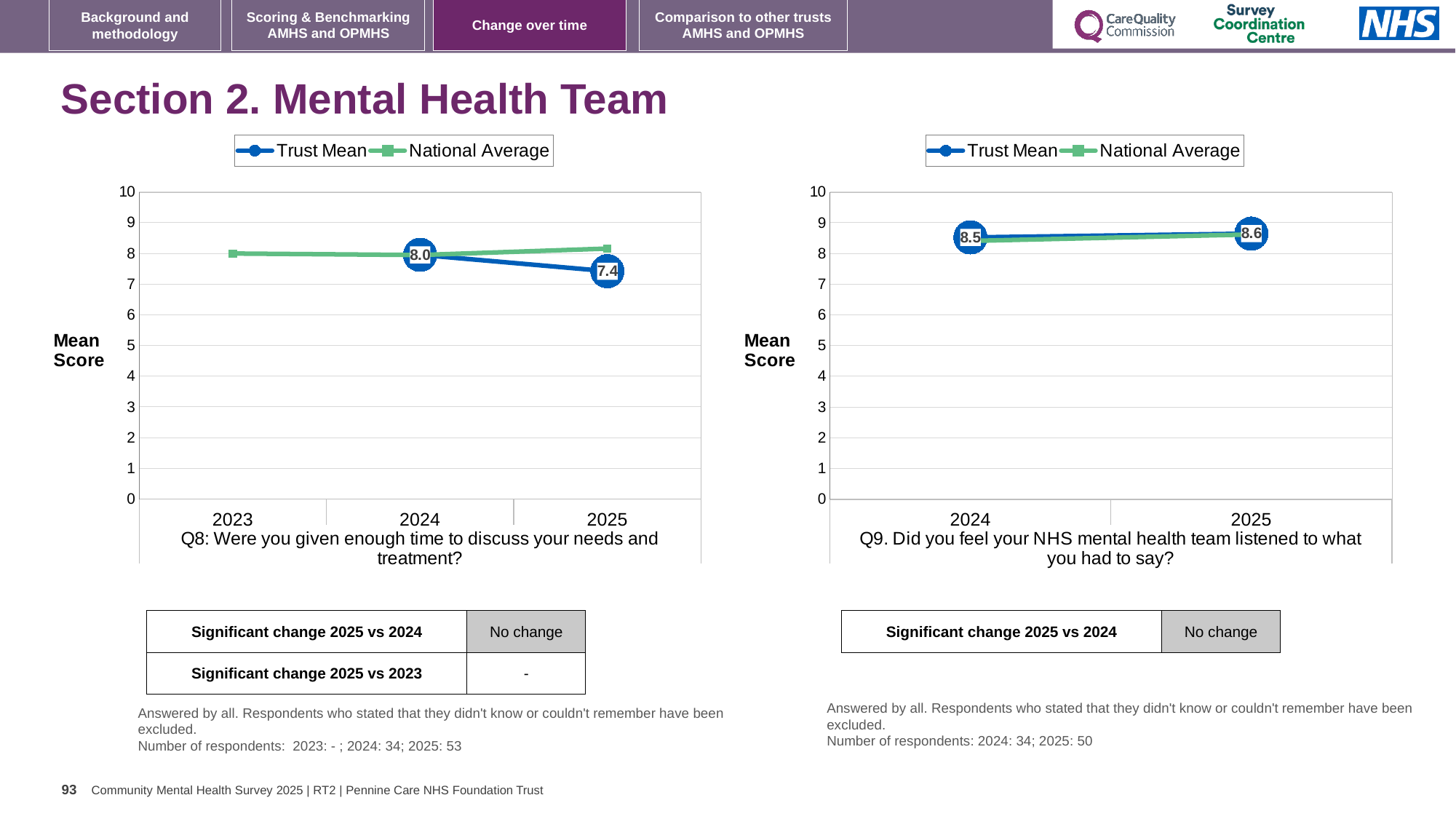
How many series does the legend of the Q8 chart on the left list? 2 In the Q8 chart on the left, what is the Trust Mean for 2024? 8.0 What kind of chart is the Q9 chart on the right? line chart In the Q8 chart on the left, which year has the lower Trust Mean, 2024 or 2025? 2025 In the Q8 chart on the left, does the Trust Mean rise or fall from 2024 to 2025? fall In the Q8 chart on the left, is the National Average for 2023 greater or less than 5? greater In the Q8 chart on the left, what is the Trust Mean for 2025? 7.4 How many years are shown on the x axis of the Q9 chart on the right? 2 How many years are shown on the x axis of the Q8 chart on the left? 3 In the Q9 chart on the right, what is the Trust Mean for 2024? 8.5 In the Q9 chart on the right, what is the Trust Mean for 2025? 8.6 In the Q8 chart on the left, by how much did the Trust Mean fall from 2024 to 2025? 0.6